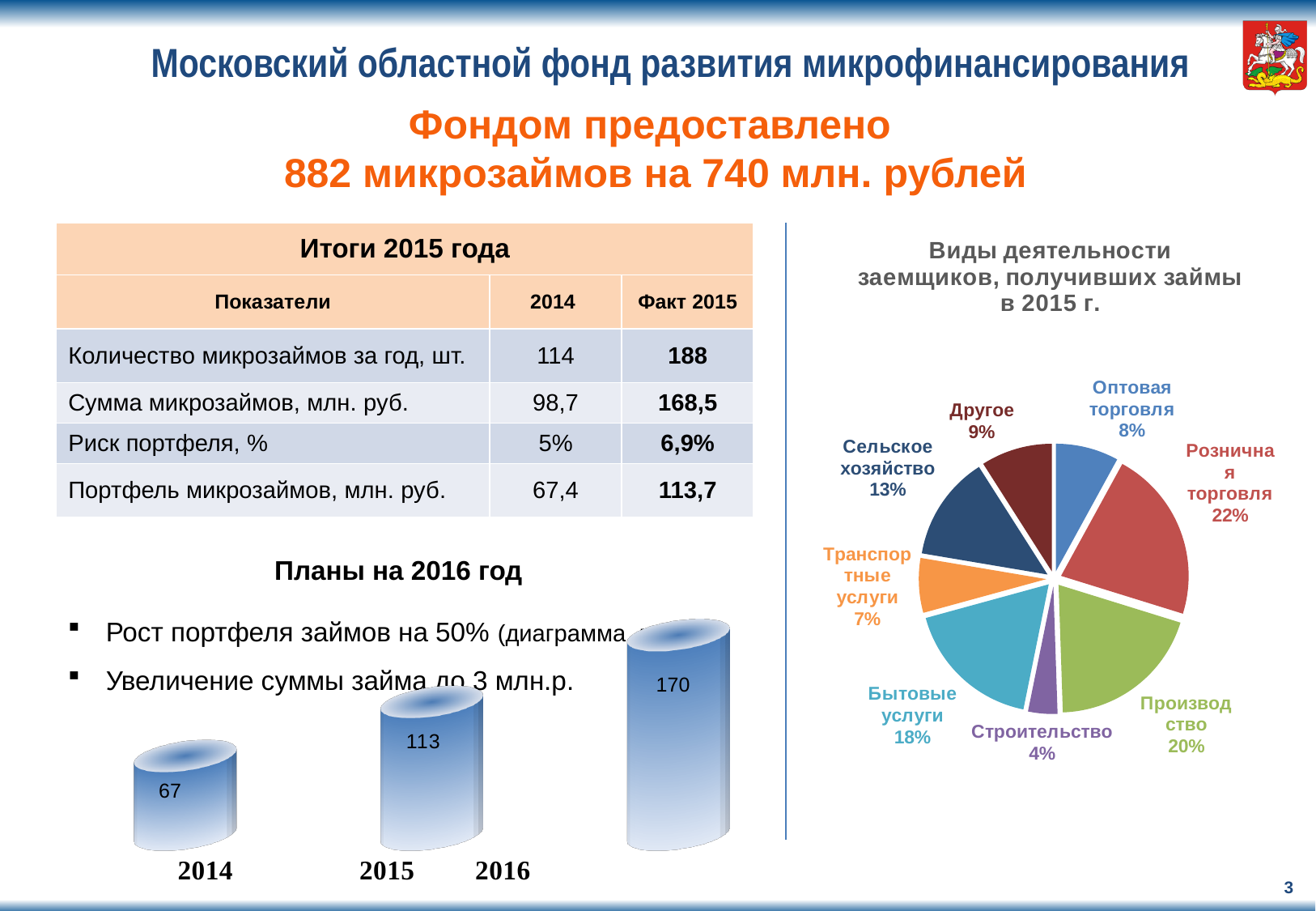
In the pie chart on the right, which category has the largest share? Розничная торговля In the bar chart at the bottom left, what is the value for 2015? 113 In the bar chart at the bottom left, do the values rise or fall from 2014 to 2016? Rise In the pie chart on the right, how many categories are shown? 8 In the bar chart at the bottom left, what is the value for 2016? 170 In the pie chart on the right, what share is Бытовые услуги? 18% In the bar chart at the bottom left, what is the difference between the 2016 and 2014 values? 103 In the pie chart on the right, which category has the smallest share? Строительство In the pie chart on the right, what is the difference in percentage points between Производство and Транспортные услуги? 13 What kind of chart is shown on the right side of the slide? Pie chart In the pie chart 'Виды деятельности заемщиков, получивших займы в 2015 г.', what share is Розничная торговля? 22% In the pie chart on the right, which is larger: Сельское хозяйство or Другое? Сельское хозяйство